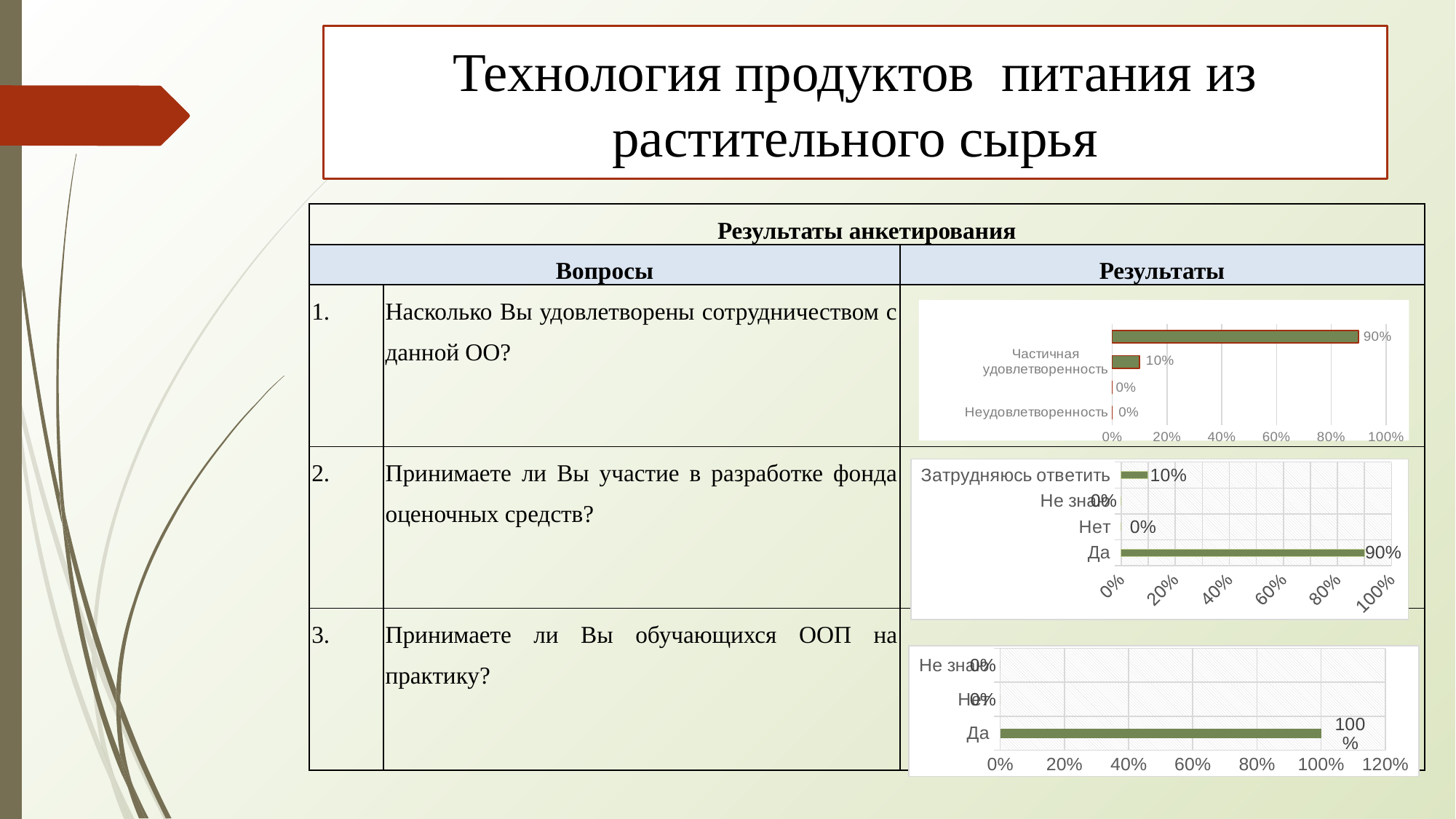
In the bottom chart (question 3), what is the value for "Нет"? 0% In the middle chart (question 2), which category has the highest value? Да In the middle chart (question 2), which is larger, the value for "Да" or the value for "Нет"? Да In the middle chart (question 2, about participating in developing the fund of assessment tools), what is the value for "Да"? 90% In the bottom chart (question 3, about taking students on practical training), what is the value for "Да"? 100% In the middle chart (question 2), what is the value for "Затрудняюсь ответить"? 10% In the top chart (question 1, about satisfaction with cooperation), what is the value for "Частичная удовлетворенность"? 10% In the bottom chart (question 3), how many categories are plotted? 3 In the top chart (question 1), what is the value for "Неудовлетворенность"? 0% In the middle chart (question 2), how many categories are plotted? 4 In the middle chart (question 2), what is the difference between the values for "Да" and "Затрудняюсь ответить"? 80% What type of chart is the bottom chart (question 3)? Bar chart